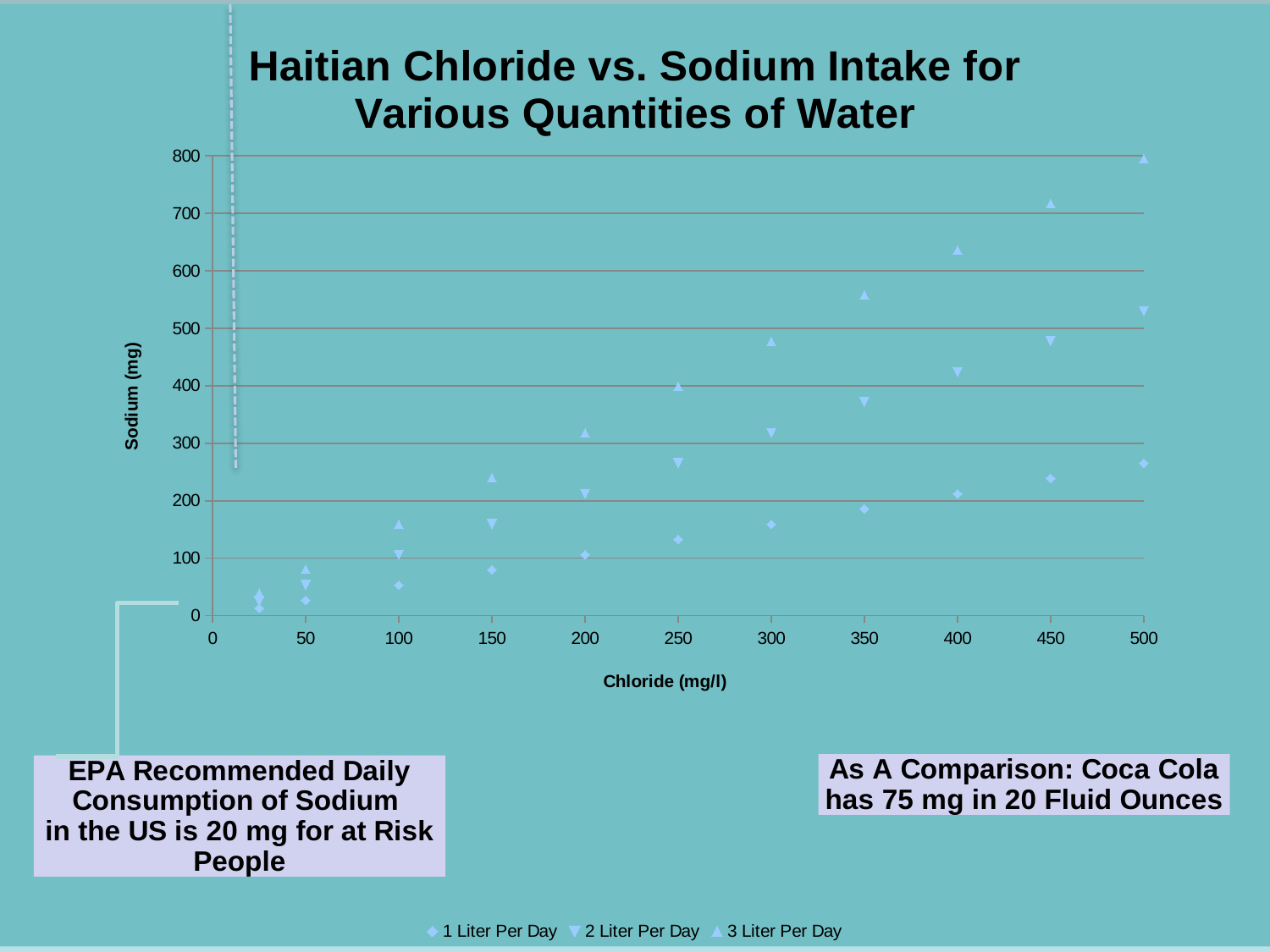
Which series has the lowest sodium value at 500 mg/l chloride? 1 Liter Per Day How many tick labels are shown on the Chloride (mg/l) axis? 11 What is the title of the chart? Haitian Chloride vs. Sodium Intake for Various Quantities of Water Is the sodium value for 1 Liter Per Day at 350 mg/l chloride greater or less than 200? less How many series does the legend list? 3 What is the label of the vertical axis? Sodium (mg) Is the sodium value for 3 Liter Per Day at 450 mg/l chloride greater or less than 700? greater Which series has the highest sodium value at 500 mg/l chloride? 3 Liter Per Day Is the sodium value for 2 Liter Per Day at 450 mg/l chloride greater or less than 500? less Do the sodium values for each series rise or fall as chloride increases along the x axis? rise What kind of chart is shown on the slide? scatter chart At 300 mg/l chloride, which is larger: the sodium value for 2 Liter Per Day or for 1 Liter Per Day? 2 Liter Per Day